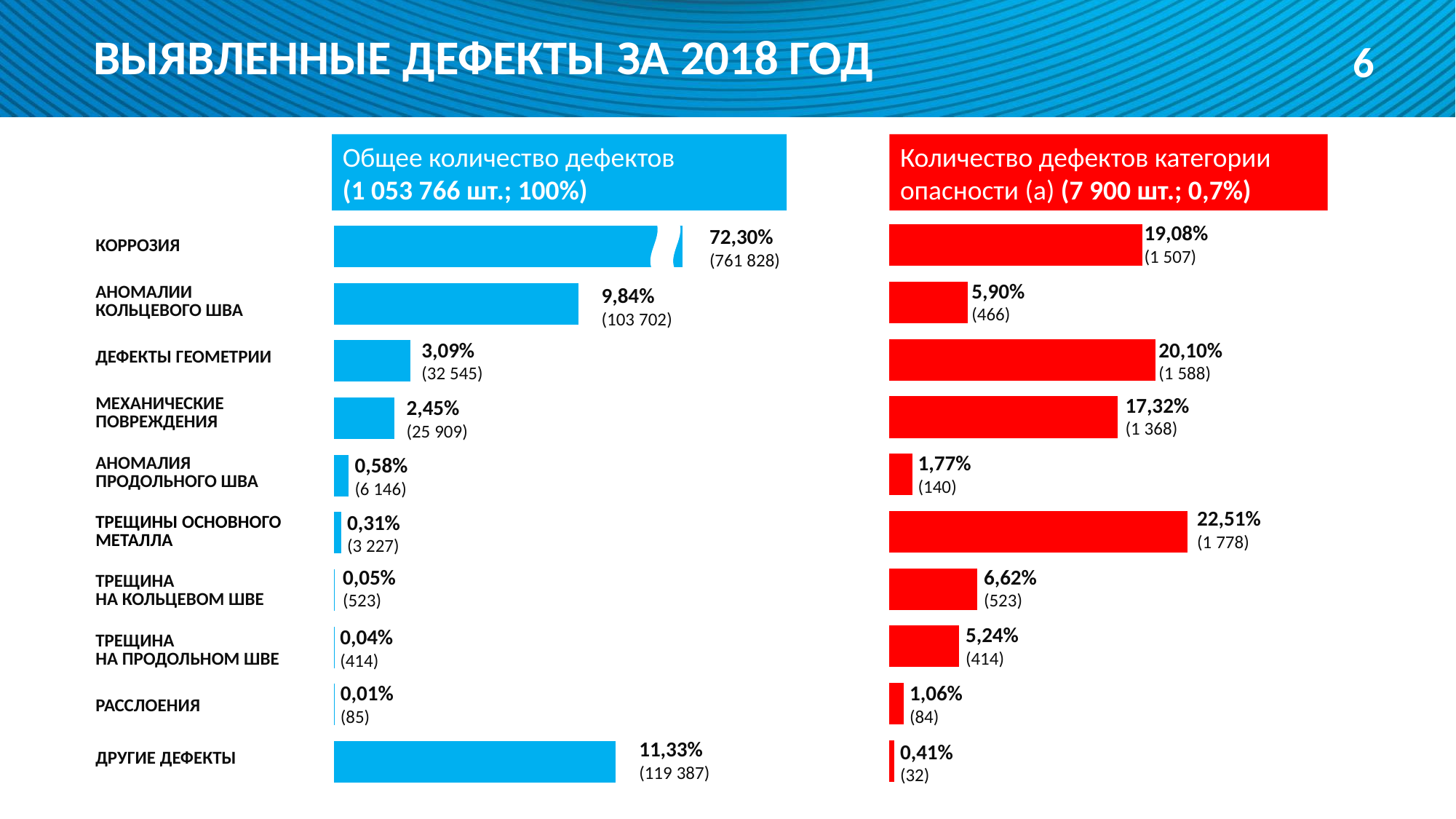
In the chart 'Количество дефектов категории опасности (а)', which is larger: the percentage for КОРРОЗИЯ or for МЕХАНИЧЕСКИЕ ПОВРЕЖДЕНИЯ? КОРРОЗИЯ In the chart 'Количество дефектов категории опасности (а)', which category has the highest percentage? ТРЕЩИНЫ ОСНОВНОГО МЕТАЛЛА How many categories are listed in the chart 'Общее количество дефектов'? 10 In the chart 'Общее количество дефектов', which category has the lowest percentage? РАССЛОЕНИЯ In the chart 'Количество дефектов категории опасности (а)', what percentage is shown for ТРЕЩИНЫ ОСНОВНОГО МЕТАЛЛА? 22,51% What type of chart is used on the slide? Bar chart In the chart 'Общее количество дефектов', what is the count shown in parentheses for АНОМАЛИИ КОЛЬЦЕВОГО ШВА? 103 702 In the chart 'Количество дефектов категории опасности (а)', what is the count shown in parentheses for ДЕФЕКТЫ ГЕОМЕТРИИ? 1 588 In the chart 'Количество дефектов категории опасности (а)', which category has the lowest percentage? ДРУГИЕ ДЕФЕКТЫ In the chart 'Общее количество дефектов', what is the difference in percentage points between КОРРОЗИЯ and ДРУГИЕ ДЕФЕКТЫ? 60,97 In the chart 'Общее количество дефектов', what percentage is shown for КОРРОЗИЯ? 72,30% What total number of defects is stated in the header of the chart 'Количество дефектов категории опасности (а)'? 7 900 шт.; 0,7%